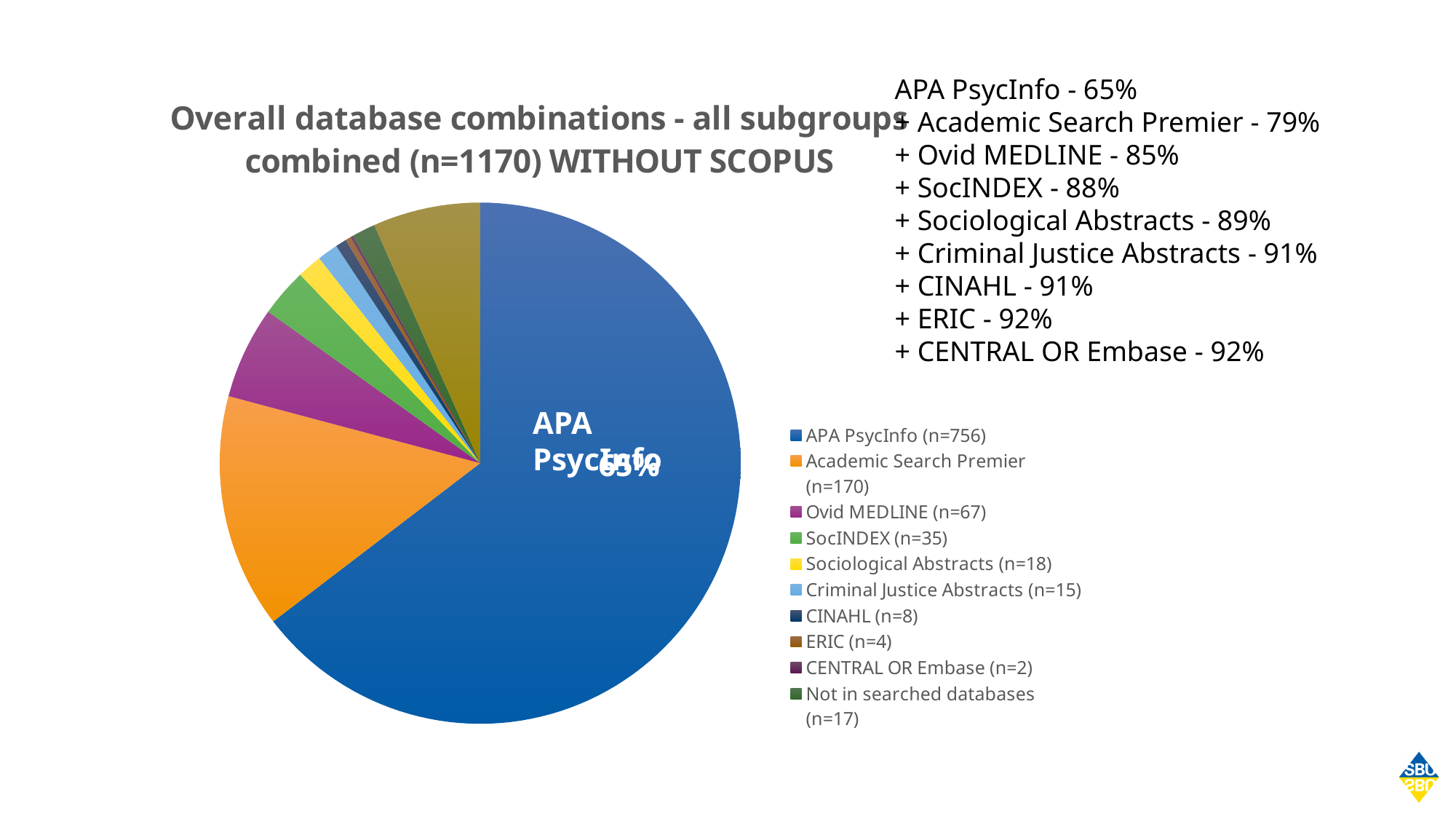
How many categories does the pie chart's legend list? 10 Which has a larger n value, SocINDEX or Sociological Abstracts? SocINDEX Which category has the smallest n value in the legend? CENTRAL OR Embase What kind of chart is shown on the slide? pie chart What is the n value shown in the legend for Not in searched databases? 17 What is the difference between the n values for Academic Search Premier and Ovid MEDLINE? 103 What is the difference between the n values for SocINDEX and Sociological Abstracts? 17 What percentage share of the pie is labelled for the APA PsycInfo slice? 65% Which category has the largest slice of the pie chart? APA PsycInfo What is the title of the pie chart? Overall database combinations - all subgroups combined (n=1170) WITHOUT SCOPUS What is the n value shown in the legend for Academic Search Premier? 170 What is the n value shown in the legend for Ovid MEDLINE? 67